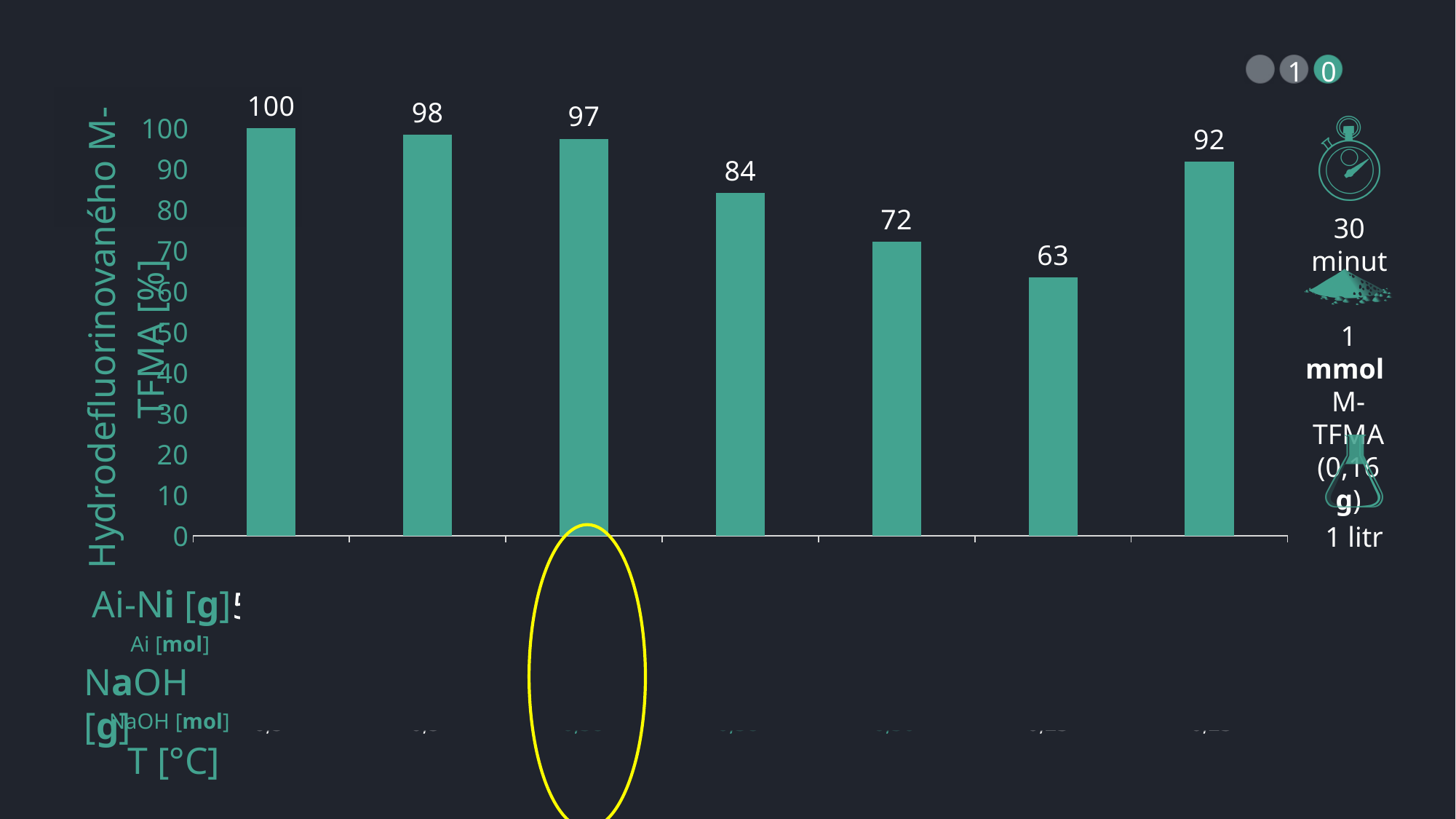
What is the label of the vertical axis of the chart? Hydrodefluorinovaného M-TFMA [%] What kind of chart is shown on the slide? Bar chart What is the value of the fourth bar from the left? 84 What is the value of the last (rightmost) bar in the chart? 92 How many bars are plotted in the chart? 7 What is the value of the first (leftmost) bar in the chart? 100 Which is larger, the value of the fifth bar or the value of the seventh bar? The seventh bar (92) Which bar has the highest value in the chart? The first (leftmost) bar, 100 What is the difference between the fourth bar (84) and the fifth bar (72)? 12 Is the value of the sixth bar greater or less than 70? less What is the difference between the value of the first bar (100) and the sixth bar (63)? 37 Which bar has the lowest value in the chart? The sixth bar, 63